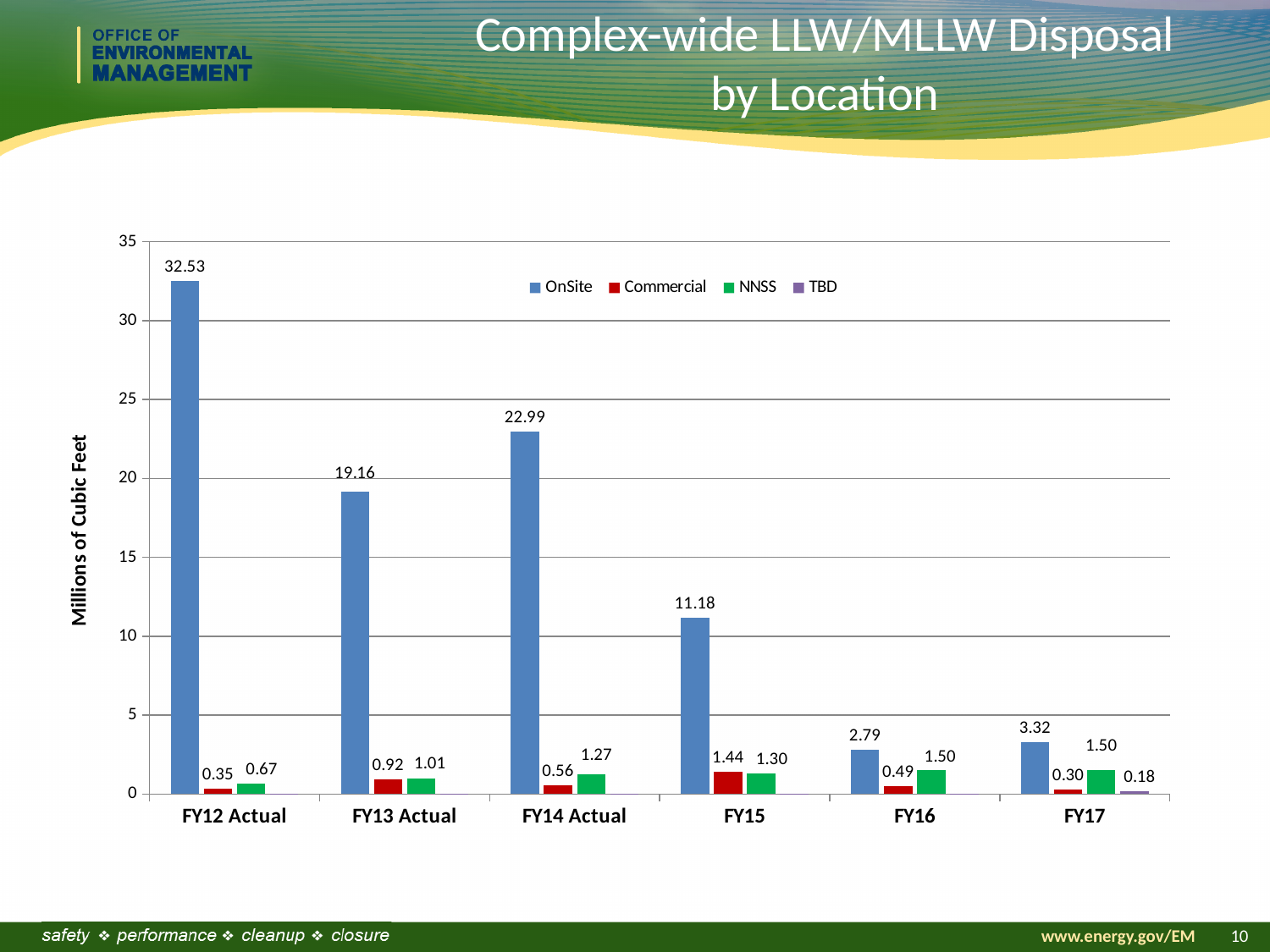
What is the difference between the OnSite values for FY14 Actual and FY13 Actual? 3.83 Which fiscal year has the highest OnSite value? FY12 Actual How many series does the legend list? 4 What is the OnSite value for FY12 Actual? 32.53 What is the label on the vertical axis? Millions of Cubic Feet What is the Commercial value for FY15? 1.44 Which fiscal year has the lowest OnSite value? FY16 What is the TBD value for FY17? 0.18 How many fiscal year categories are shown on the x axis? 6 Which is larger for FY15, the Commercial value or the NNSS value? Commercial What kind of chart is shown on the slide? Bar chart What is the NNSS value for FY14 Actual? 1.27